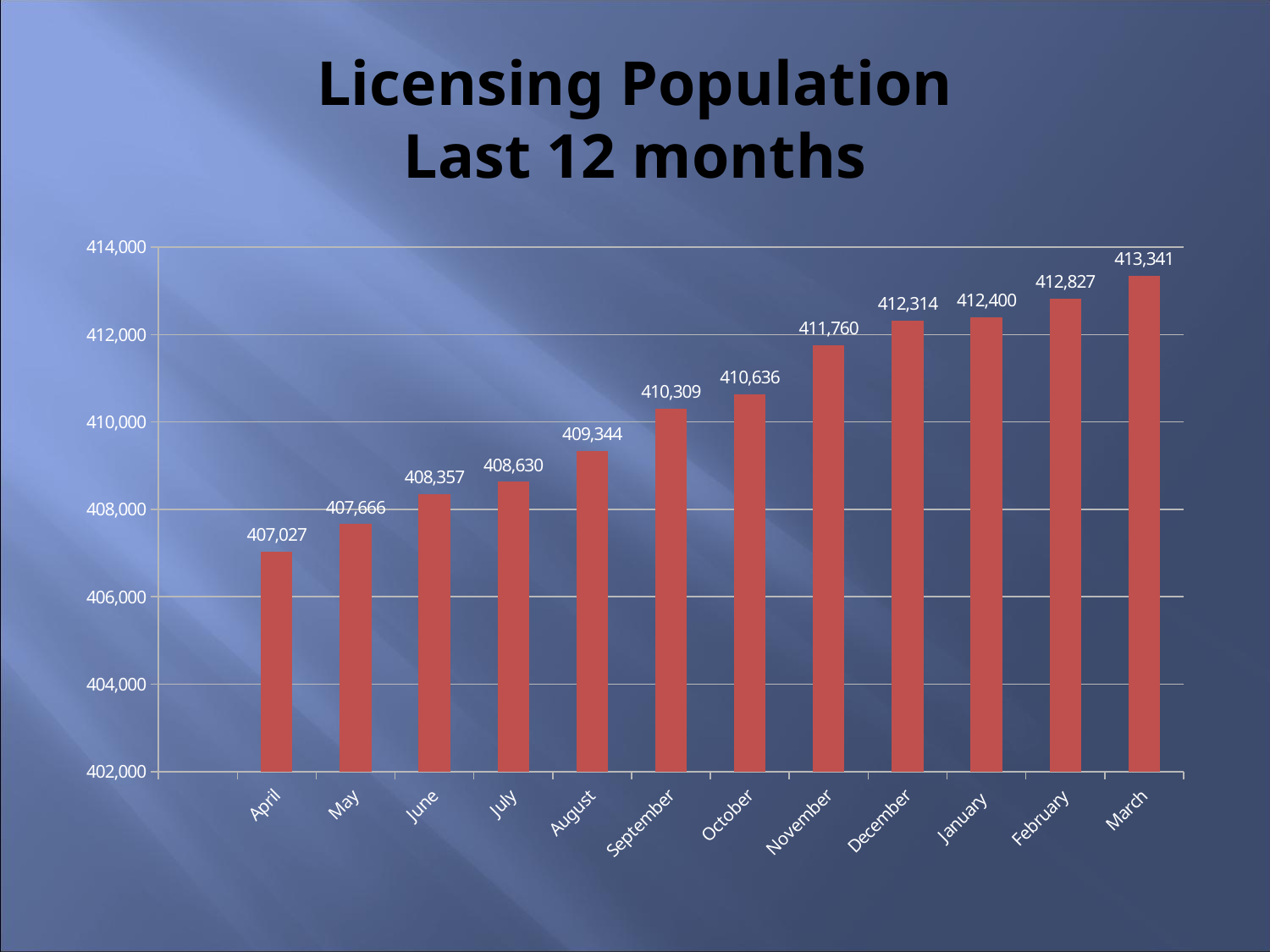
Is the value for July greater or less than 410,000? less Do the values rise or fall from April to March? Rise Which month has a larger licensing population, June or December? December How many months are shown on the chart? 12 What is the difference between the licensing population in October and in September? 327 What is the licensing population for November? 411,760 Which month has the lowest licensing population? April What is the licensing population for August? 409,344 What is the licensing population for April? 407,027 What is the difference between the licensing population in March and in April? 6,314 Which month has the highest licensing population? March What kind of chart is shown on the slide? Bar chart